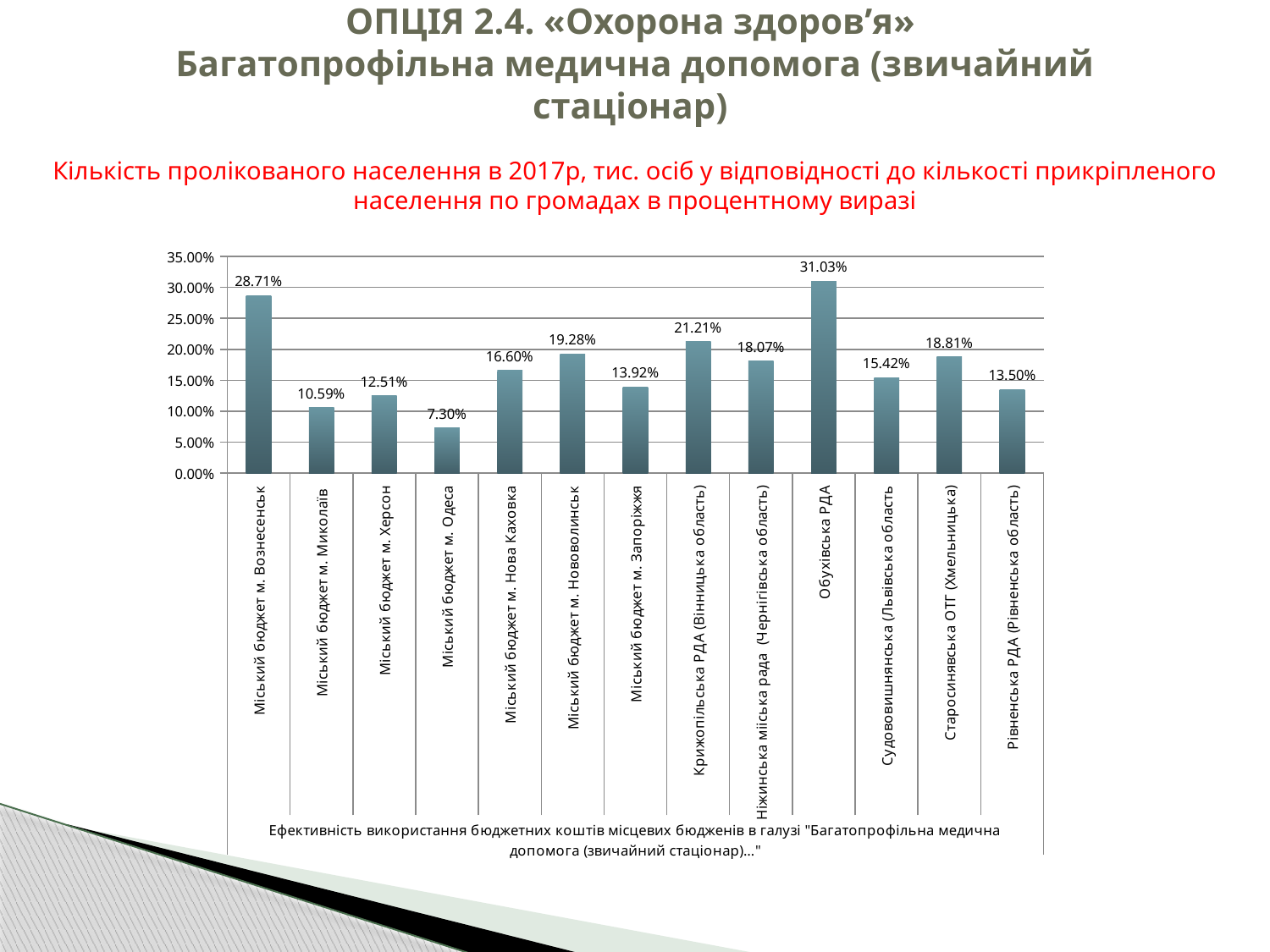
Which category has the lowest value? Міський бюджет м. Одеса Which category has the highest value? Обухівська РДА What is the value for Міський бюджет м. Вознесенськ? 28.71% What kind of chart is shown on the slide? bar chart What is the value for Старосинявська ОТГ (Хмельницька)? 18.81% What is the value for Міський бюджет м. Одеса? 7.30% Is the value for Міський бюджет м. Запоріжжя greater or less than 15.00%? less What is the difference between the values for Обухівська РДА and Міський бюджет м. Вознесенськ? 2.32% How many categories are shown in the chart? 13 What is the value for Крижопільська РДА (Вінницька область)? 21.21% Which is larger: the value for Міський бюджет м. Нововолинськ or the value for Міський бюджет м. Нова Каховка? Міський бюджет м. Нововолинськ What is the difference between the values for Крижопільська РДА (Вінницька область) and Ніжинська міська рада (Чернігівська область)? 3.14%